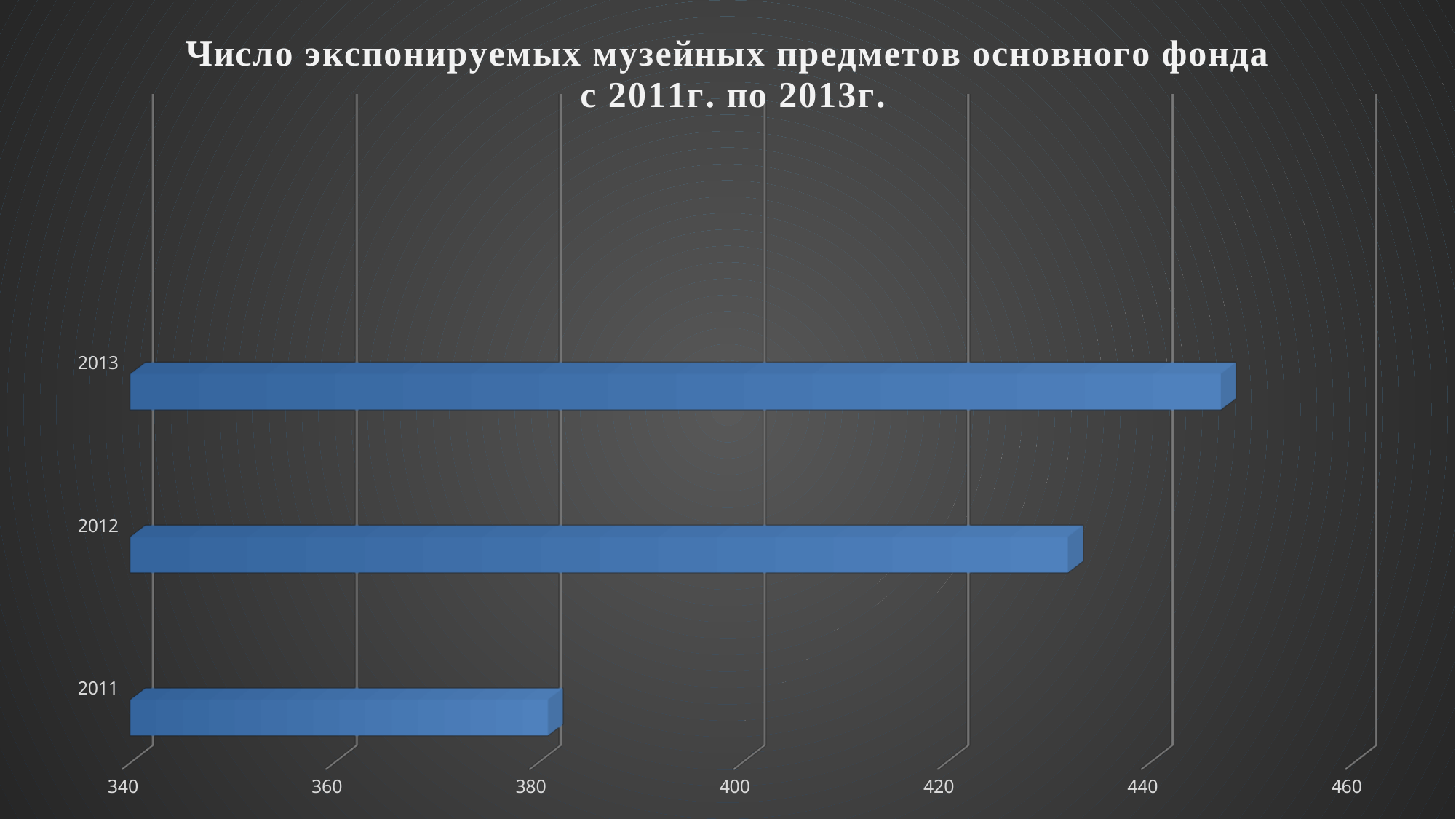
Is the value for 2011 greater or less than 400? less Which year has the larger value, 2012 or 2013? 2013 Is the value for 2013 greater or less than 440? greater Which year has the larger value, 2011 or 2012? 2012 What kind of chart is shown on the slide? bar chart Is the value for 2012 greater or less than 440? less Which year has the highest number of exhibited museum items? 2013 Do the values rise or fall from 2011 to 2013? rise What is the title of the chart? Число экспонируемых музейных предметов основного фонда с 2011г. по 2013г. How many years (categories) are plotted on the chart? 3 Which year has the lowest number of exhibited museum items? 2011